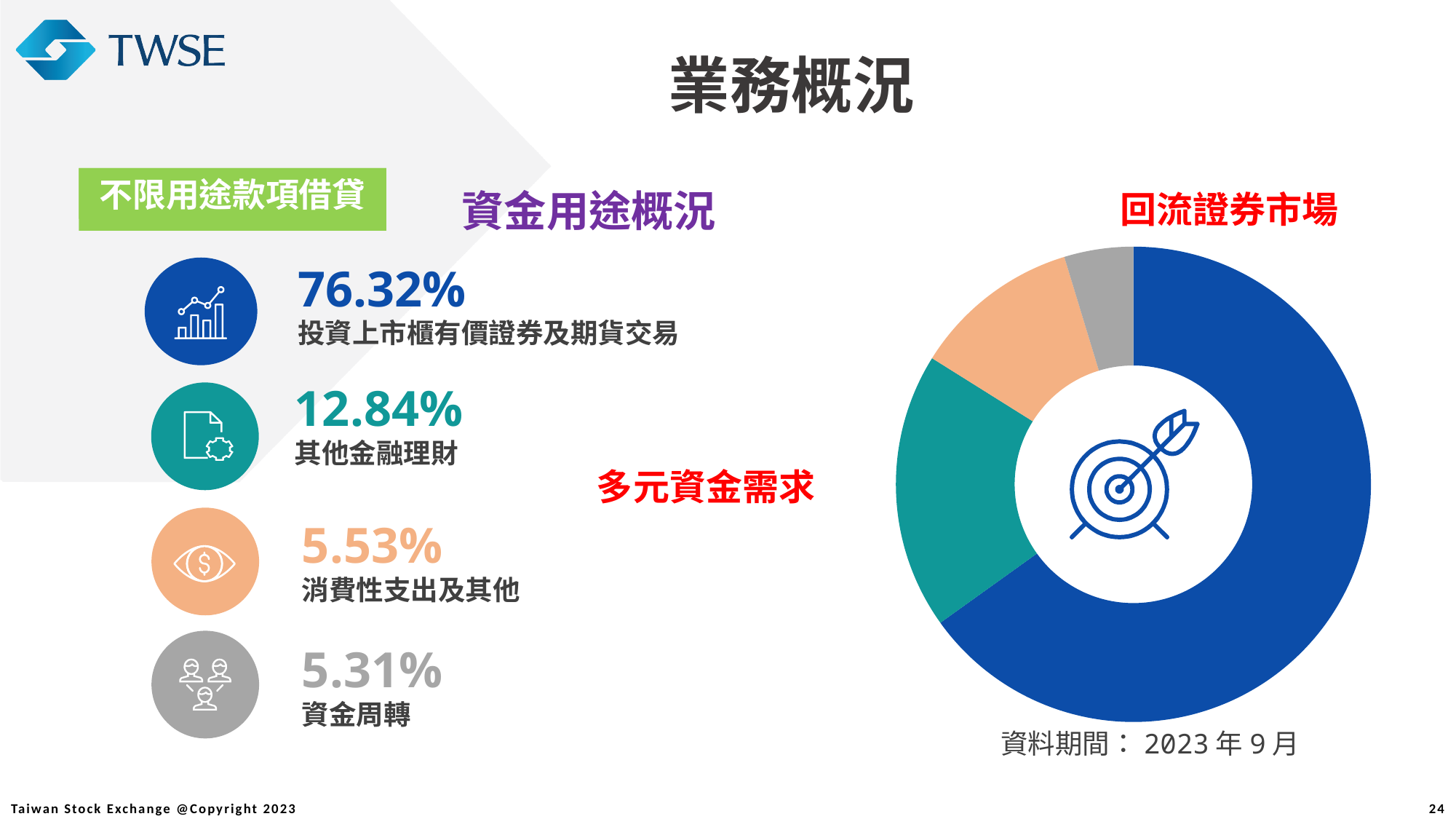
Which is larger, the share for 消費性支出及其他 or the share for 資金周轉? 消費性支出及其他 What share of the donut chart is 投資上市櫃有價證券及期貨交易? 76.32% Which category has the largest share of the donut chart? 投資上市櫃有價證券及期貨交易 Which category has the smallest share of the donut chart? 資金周轉 What is the difference between the shares of 投資上市櫃有價證券及期貨交易 and 其他金融理財? 63.48% What percentage is shown for 消費性支出及其他? 5.53% What percentage is shown for 資金周轉? 5.31% What type of chart is shown on the slide? Donut (pie) chart What colour is the segment representing 其他金融理財 in the donut chart? Teal What data period is stated below the donut chart? 2023 年 9 月 How many categories are shown in the donut chart? 4 What percentage is shown for 其他金融理財? 12.84%